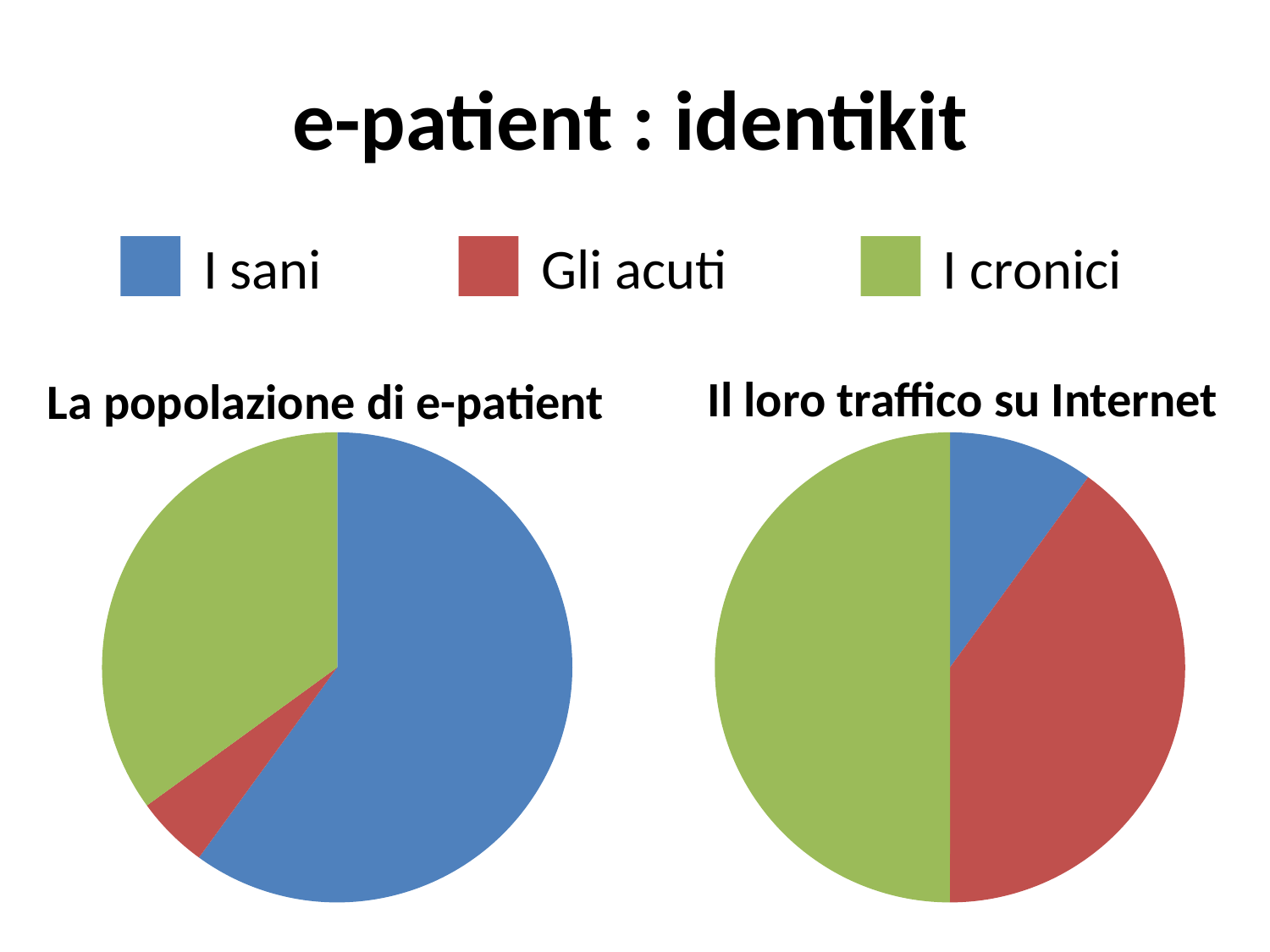
Which colour represents "Gli acuti" in the legend? Red How many slices does the "Il loro traffico su Internet" pie chart have? 3 In the "Il loro traffico su Internet" chart, which slice is larger: Gli acuti or I sani? Gli acuti What kind of chart is "La popolazione di e-patient"? Pie chart In the "La popolazione di e-patient" chart, which category has the smallest slice? Gli acuti In the "Il loro traffico su Internet" chart, which category has the largest slice? I cronici In the "La popolazione di e-patient" chart, which slice is larger: I cronici or Gli acuti? I cronici How many categories does the legend list? 3 What kind of chart is "Il loro traffico su Internet"? Pie chart What is the title of the pie chart on the left of the slide? La popolazione di e-patient In the "La popolazione di e-patient" chart, which category has the largest slice? I sani In the "Il loro traffico su Internet" chart, which category has the smallest slice? I sani